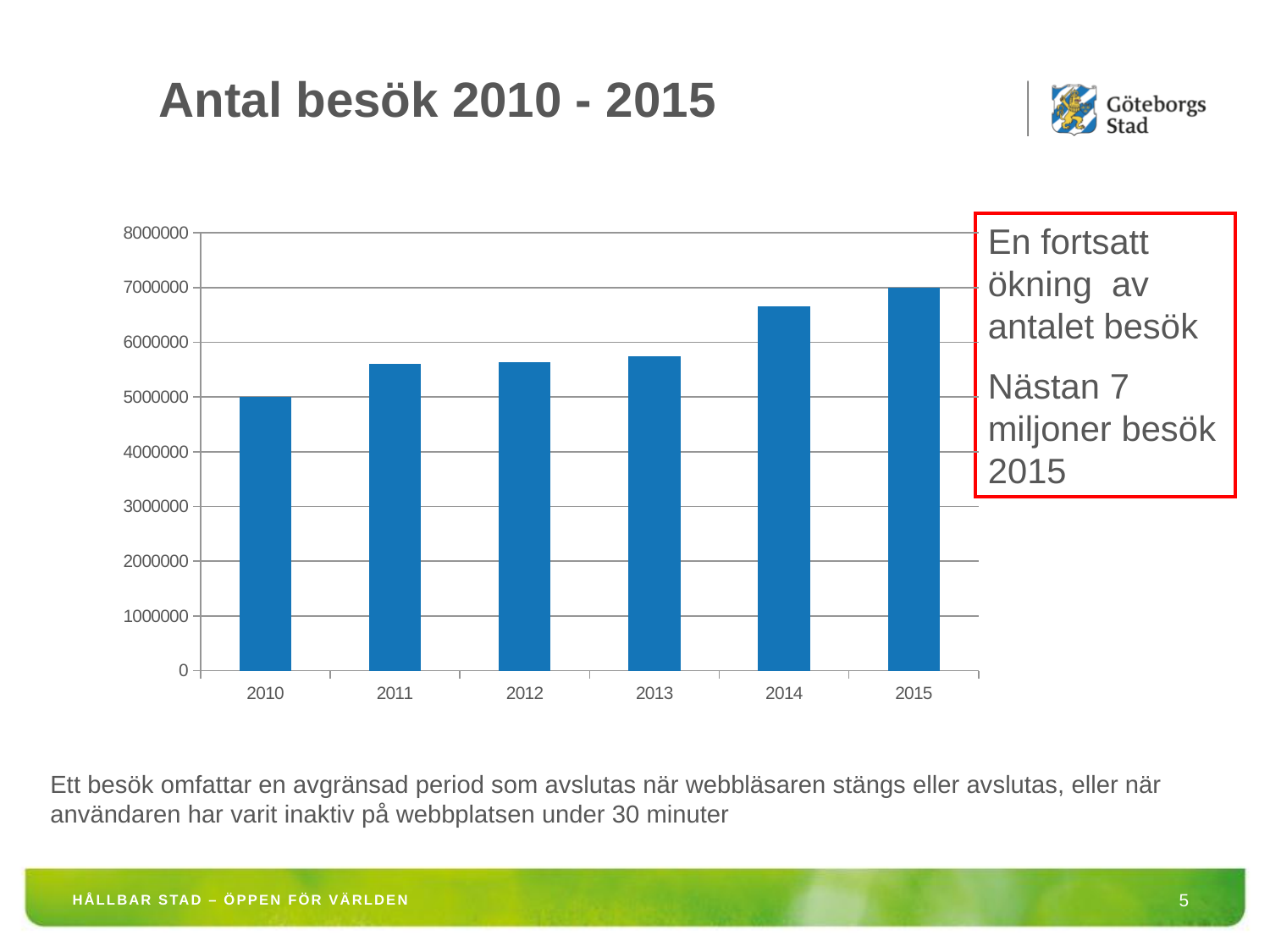
Which year has the lowest number of visits? 2010 What is the title of the chart? Antal besök 2010 - 2015 Is the value for 2011 greater or less than 5000000? greater Do the values rise or fall from 2010 to 2015? rise Is the value for 2014 greater or less than 6000000? greater What kind of chart is shown on the slide? bar chart Is the value for 2015 greater or less than 8000000? less Which year has the highest number of visits? 2015 Which year has more visits, 2013 or 2014? 2014 How many years are shown on the x axis of the chart? 6 Which year has more visits, 2010 or 2011? 2011